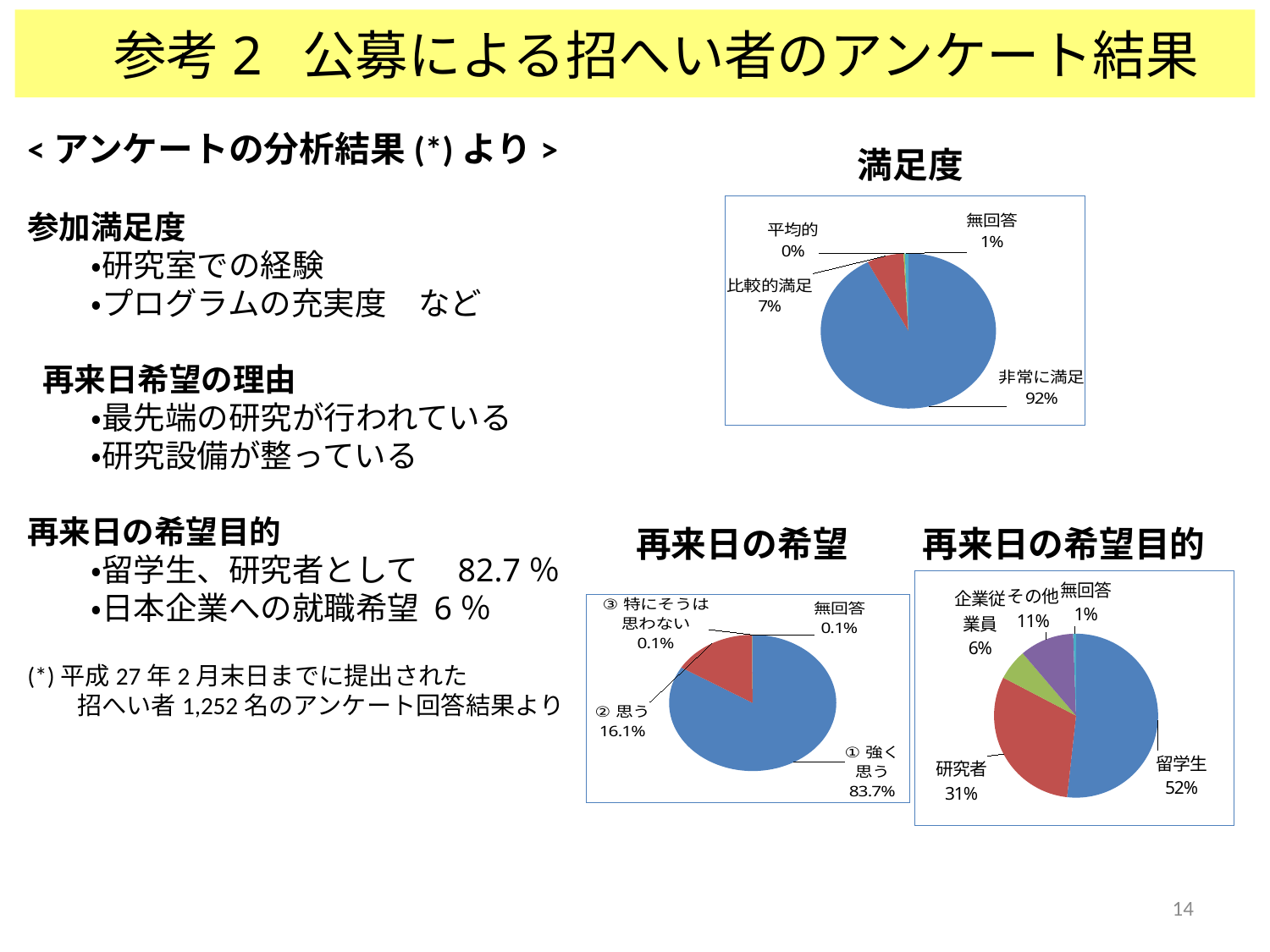
「再来日の希望目的」のグラフで、「留学生」と「その他」ではどちらの割合が大きいですか？ 留学生 「再来日の希望目的」のグラフはどの種類のグラフですか？ 円グラフ 「再来日の希望目的」のグラフで、「企業従業員」の割合はいくつですか？ 6% 「満足度」のグラフで、「比較的満足」の割合はいくつですか？ 7% 「満足度」のグラフで、最も割合が大きいカテゴリはどれですか？ 非常に満足 「再来日の希望目的」のグラフで、「留学生」と「研究者」の割合の差はいくつですか？ 21% 「再来日の希望」のグラフで、「① 強く思う」の割合はいくつですか？ 83.7% 「満足度」のグラフには、いくつのカテゴリがありますか？ 4 「再来日の希望」のグラフで、「① 強く思う」と「② 思う」の差はいくつですか？ 67.6% 「再来日の希望」のグラフで、「② 思う」の割合はいくつですか？ 16.1% 「満足度」のグラフで、「非常に満足」の割合はいくつですか？ 92% 「再来日の希望目的」のグラフで、「研究者」の割合はいくつですか？ 31%